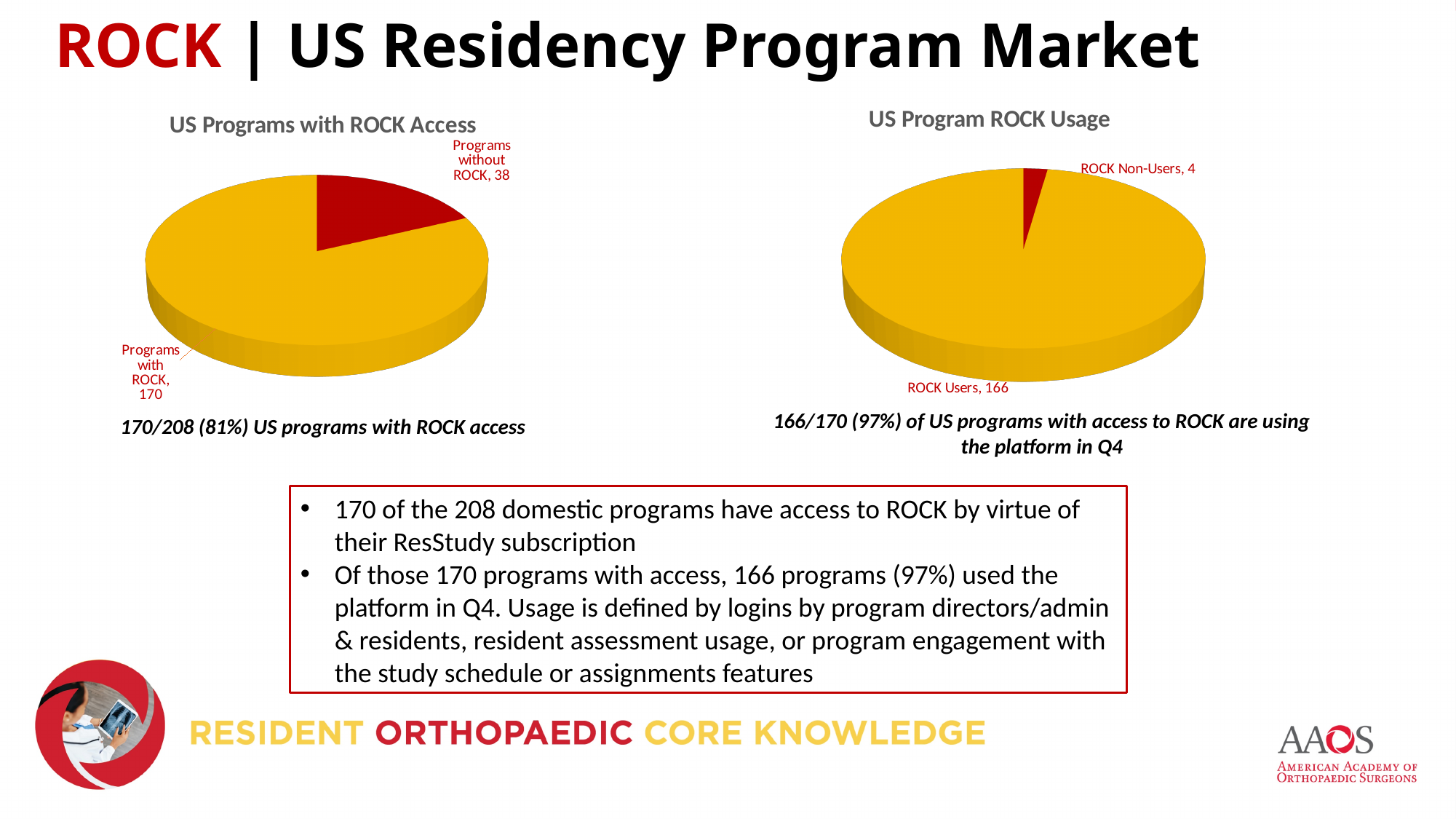
What kind of chart is the 'US Program ROCK Usage' chart? Pie chart In the 'US Programs with ROCK Access' chart, what is the difference between Programs with ROCK and Programs without ROCK? 132 In the 'US Program ROCK Usage' chart, what is the difference between ROCK Users and ROCK Non-Users? 162 In the 'US Program ROCK Usage' chart, which slice is the smallest? ROCK Non-Users How many slices does the 'US Programs with ROCK Access' chart have? 2 In the 'US Program ROCK Usage' chart, what is the value for ROCK Users? 166 In the 'US Programs with ROCK Access' chart, which slice is the largest? Programs with ROCK In the 'US Programs with ROCK Access' chart, what share of the pie do Programs with ROCK represent? 81% In the 'US Program ROCK Usage' chart, what is the value for ROCK Non-Users? 4 In the 'US Program ROCK Usage' chart, what share of the pie do ROCK Users represent? 97% In the 'US Programs with ROCK Access' chart, what is the value for Programs without ROCK? 38 In the 'US Programs with ROCK Access' chart, what is the value for Programs with ROCK? 170